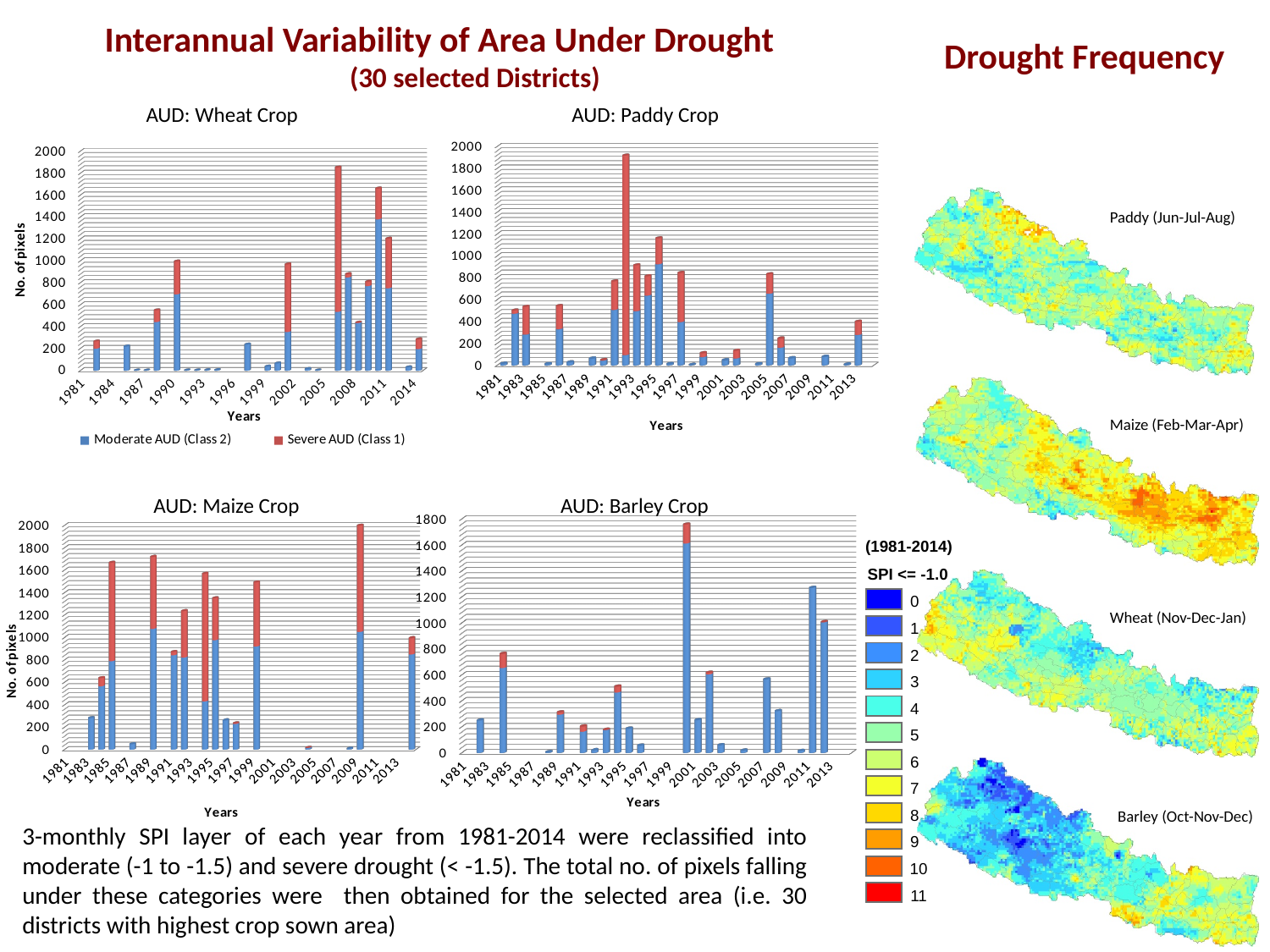
What kind of chart is the 'AUD: Wheat Crop' chart? Stacked bar chart In the 'AUD: Wheat Crop' chart, which year has the tallest bar? 2006 In the 'AUD: Wheat Crop' chart, is the total bar for 2007 greater or less than 1600? less What are the two series named in the legend under the 'AUD: Wheat Crop' chart? Moderate AUD (Class 2) and Severe AUD (Class 1) In the 'AUD: Barley Crop' chart, which year has the tallest bar? 2000 In the 'AUD: Paddy Crop' chart, which year has the tallest bar? 1992 How many series does the legend under the 'AUD: Wheat Crop' chart list? 2 In the 'AUD: Paddy Crop' chart, which year has the taller bar, 1993 or 1995? 1995 What is the y-axis label on the 'AUD: Wheat Crop' chart? No. of pixels In the 'AUD: Paddy Crop' chart, is the total bar for 1993 greater or less than 1800? less